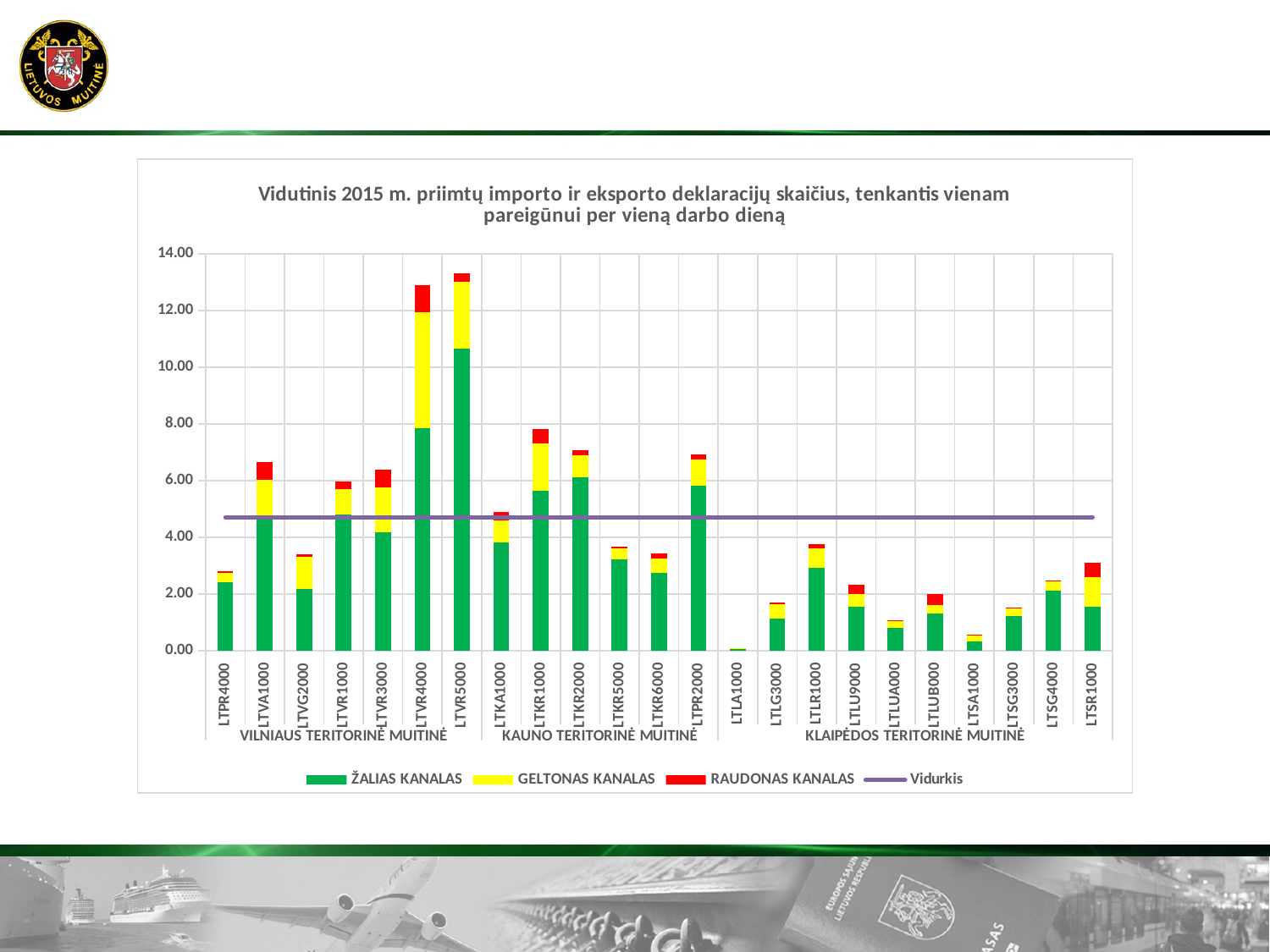
Is the total value for LTSG4000 greater or less than 4.00? less Is the total value for LTLA1000 greater or less than 2.00? less How many entries does the legend list? 4 Which has the larger total bar, LTVA1000 or LTVG2000? LTVA1000 Which customs office code has the highest total bar? LTVR5000 What kind of chart is shown on the slide? Stacked bar chart with a line How many customs office codes (bars) are shown along the x axis? 23 Is the total value for LTKR1000 greater or less than 6.00? greater Which has the larger total bar, LTKR2000 or LTKR5000? LTKR2000 Which customs office code has the lowest total bar? LTLA1000 Which legend entry is drawn as a line rather than a bar segment? Vidurkis